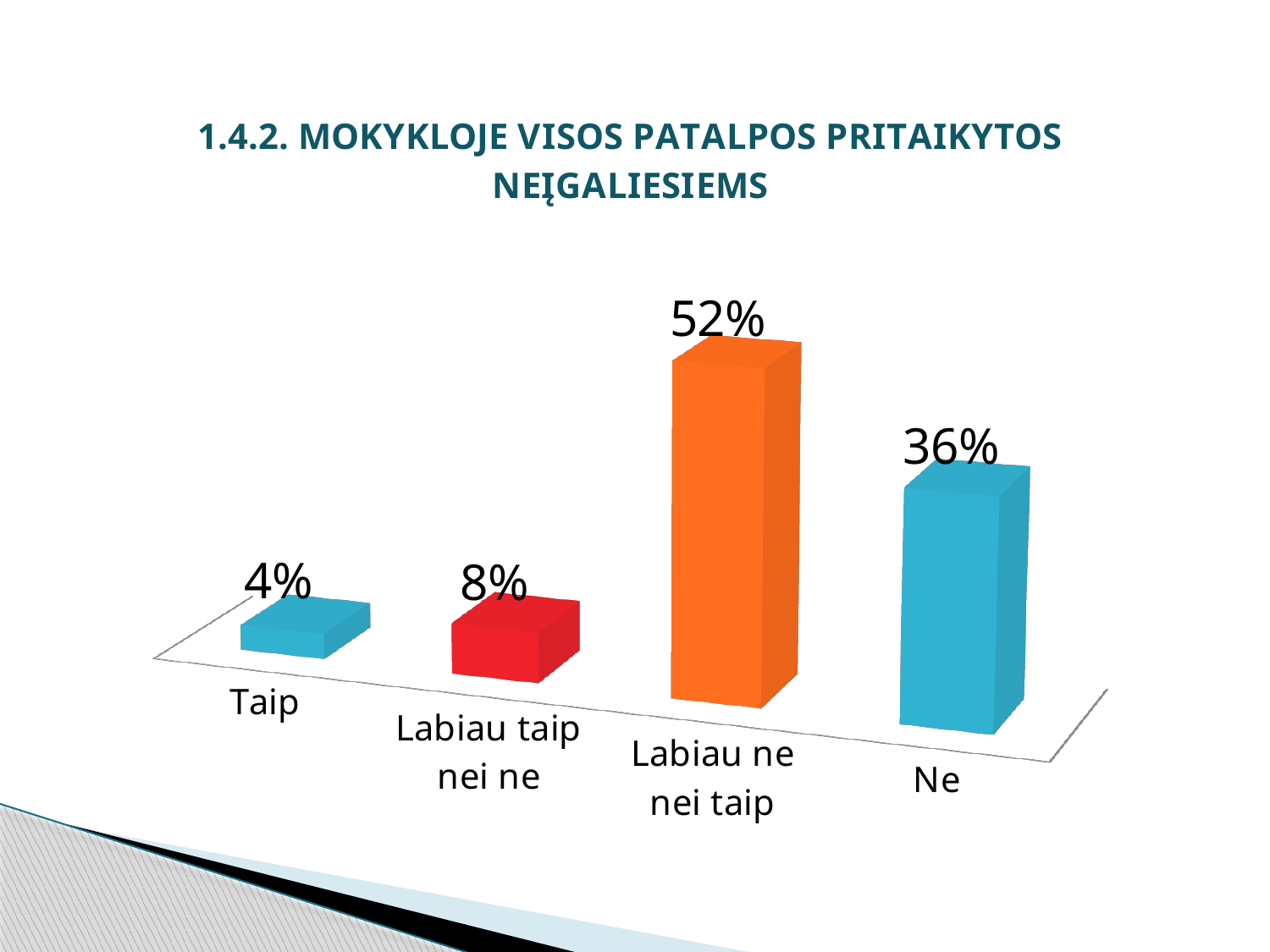
How many categories are shown in the chart? 4 What kind of chart is shown on the slide? Bar chart Which is larger, the value for "Ne" or the value for "Labiau taip nei ne"? Ne What is the difference between the values for "Labiau ne nei taip" and "Ne"? 16% What is the value for "Labiau ne nei taip"? 52% What is the title of the chart? 1.4.2. MOKYKLOJE VISOS PATALPOS PRITAIKYTOS NEĮGALIESIEMS What is the difference between the values for "Labiau taip nei ne" and "Taip"? 4% Which category has the highest value? Labiau ne nei taip What is the value for "Labiau taip nei ne"? 8% What is the value for "Ne"? 36% What is the value for "Taip"? 4% Which category has the lowest value? Taip